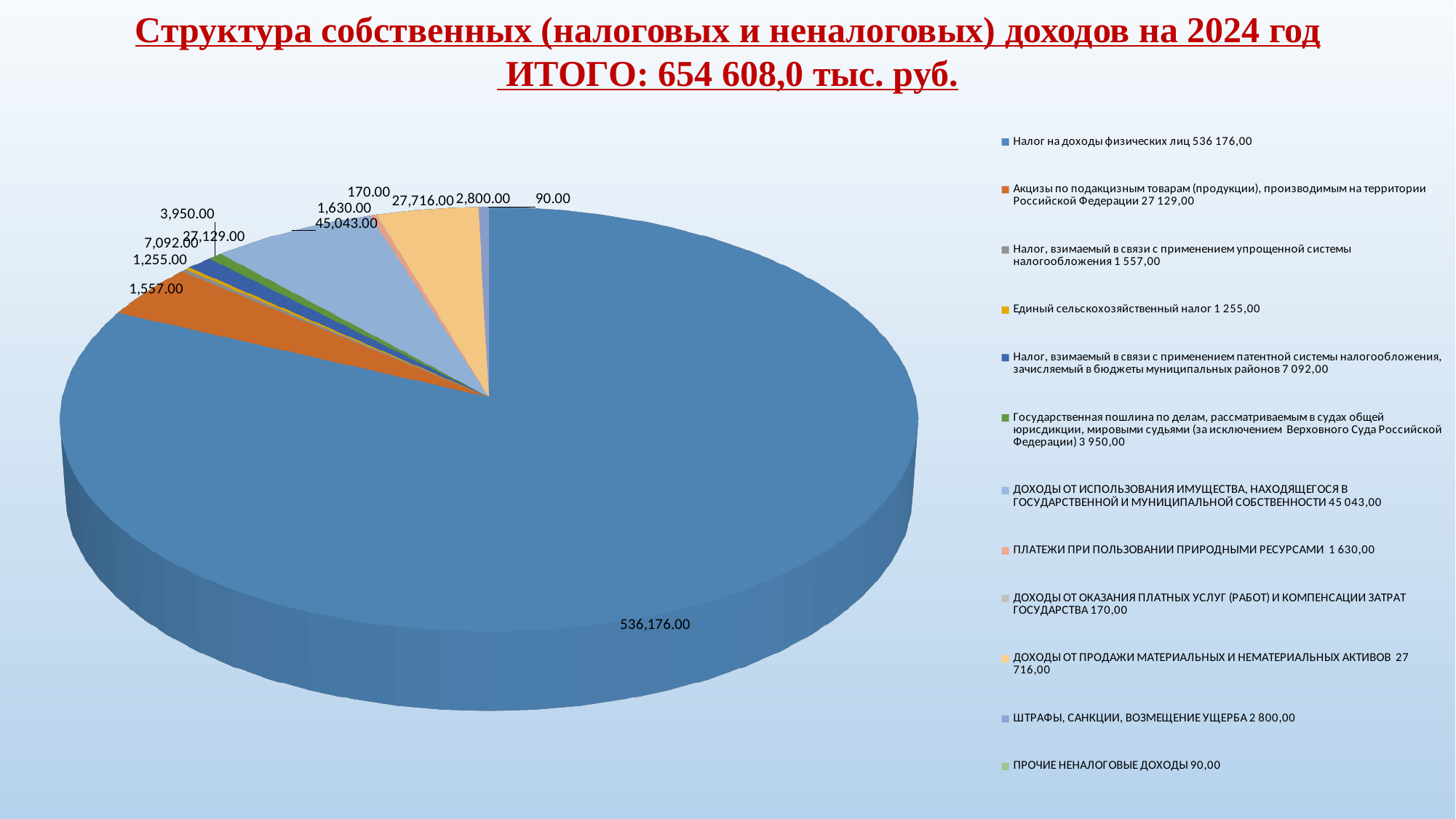
What total amount is stated in the chart title (ИТОГО)? 654 608,0 тыс. руб. How many categories does the legend of the pie chart list? 12 Which is larger: the value for Налог, взимаемый в связи с применением патентной системы налогообложения or the value for Государственная пошлина? Налог, взимаемый в связи с применением патентной системы налогообложения What is the difference between the value for ДОХОДЫ ОТ ИСПОЛЬЗОВАНИЯ ИМУЩЕСТВА and the value for ДОХОДЫ ОТ ПРОДАЖИ МАТЕРИАЛЬНЫХ И НЕМАТЕРИАЛЬНЫХ АКТИВОВ? 17,327.00 Which category has the smallest value in the pie chart? ПРОЧИЕ НЕНАЛОГОВЫЕ ДОХОДЫ What is the value for Единый сельскохозяйственный налог? 1,255.00 What is the difference between the value for ДОХОДЫ ОТ ПРОДАЖИ МАТЕРИАЛЬНЫХ И НЕМАТЕРИАЛЬНЫХ АКТИВОВ and the value for Акцизы по подакцизным товарам? 587.00 What is the value for ДОХОДЫ ОТ ИСПОЛЬЗОВАНИЯ ИМУЩЕСТВА, НАХОДЯЩЕГОСЯ В ГОСУДАРСТВЕННОЙ И МУНИЦИПАЛЬНОЙ СОБСТВЕННОСТИ? 45,043.00 What is the value for ШТРАФЫ, САНКЦИИ, ВОЗМЕЩЕНИЕ УЩЕРБА? 2,800.00 What is the value for Налог на доходы физических лиц? 536,176.00 Which category has the largest slice of the pie? Налог на доходы физических лиц What kind of chart is shown on the slide? pie chart